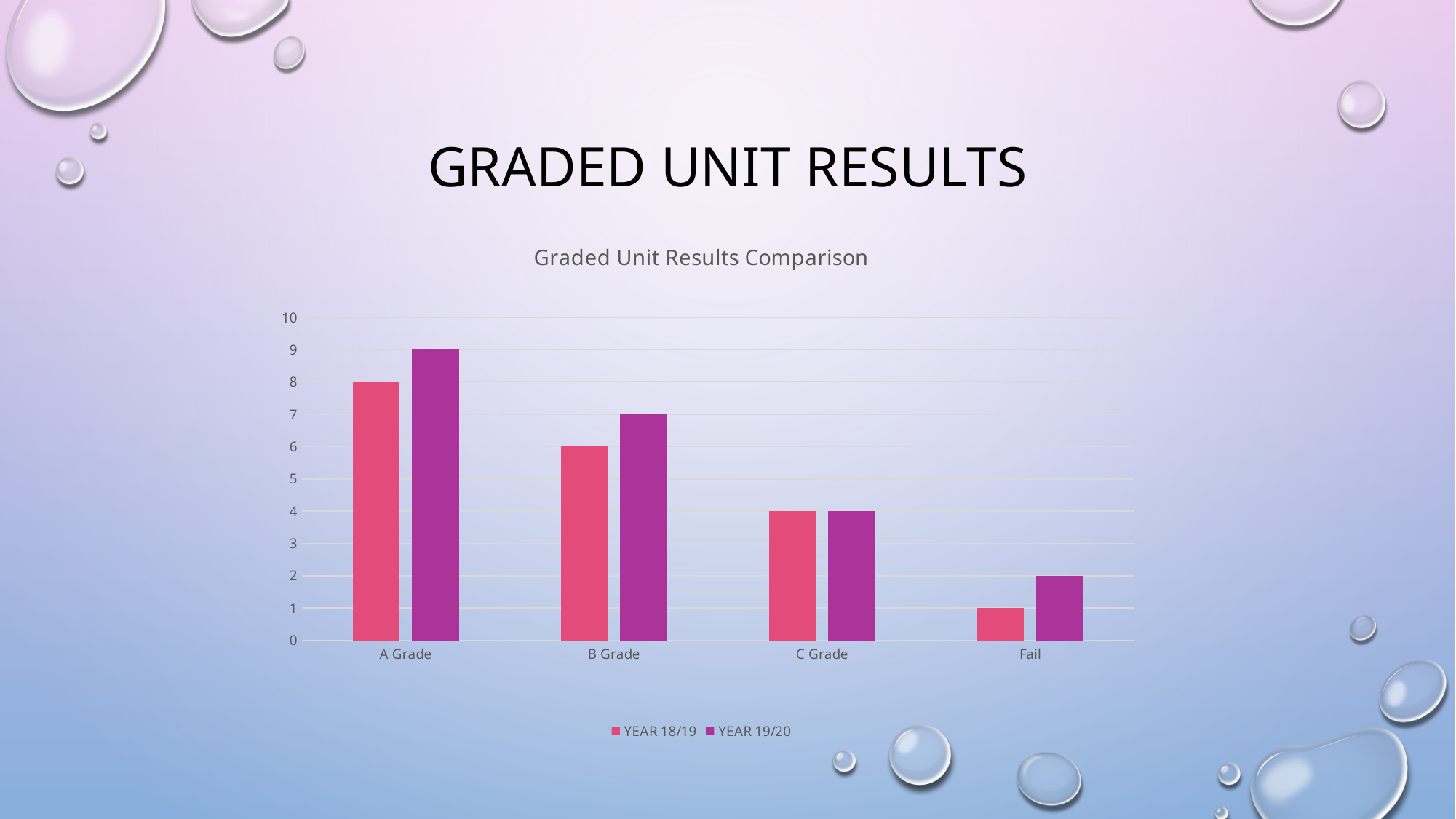
What is the value for B Grade in the Year 19/20 series? 7 How many series does the legend list? 2 Which is larger for Fail: the Year 18/19 value or the Year 19/20 value? Year 19/20 What kind of chart is shown on the slide? Bar chart What is the difference between the Year 19/20 and Year 18/19 values for B Grade? 1 What is the value for A Grade in the Year 19/20 series? 9 What is the value for Fail in the Year 18/19 series? 1 Which category has the highest value in the Year 19/20 series? A Grade Which category has the lowest value in the Year 18/19 series? Fail What is the title of the chart? Graded Unit Results Comparison What is the value for A Grade in the Year 18/19 series? 8 How many categories are shown on the x axis? 4